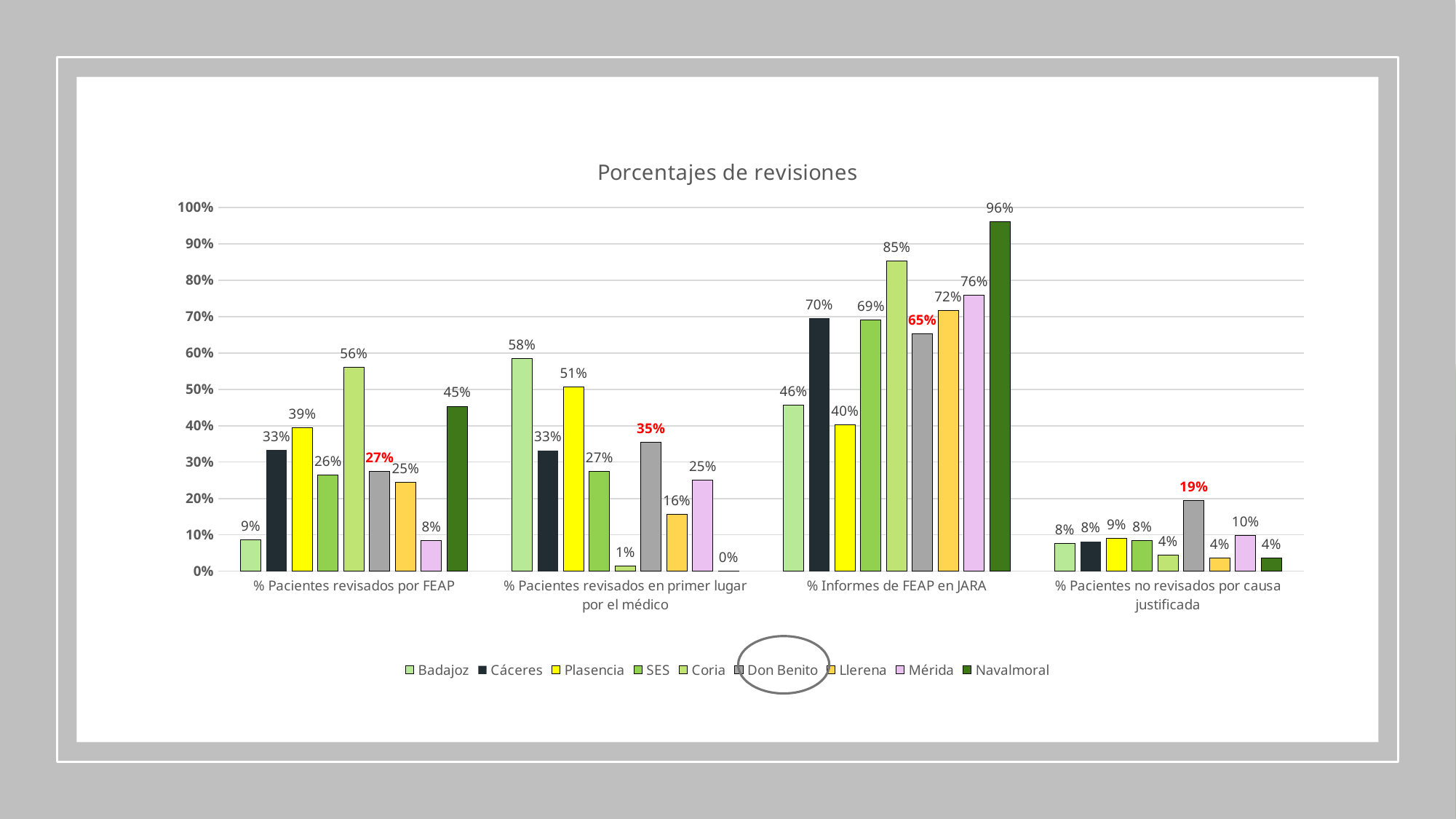
Which series has the lowest value in the "% Pacientes revisados por FEAP" category? Mérida How many categories are shown on the x axis? 4 In the "% Pacientes no revisados por causa justificada" category, which is larger: Don Benito or Mérida? Don Benito What kind of chart is shown on the slide? Bar chart What is the title of the chart? Porcentajes de revisiones Which series has the highest value in the "% Informes de FEAP en JARA" category? Navalmoral Which legend entry is circled on the slide? Don Benito What is the value for Don Benito in the "% Informes de FEAP en JARA" category? 65% How many series does the legend list? 9 What is the value for Navalmoral in the "% Pacientes revisados en primer lugar por el médico" category? 0% What is the value for Coria in the "% Pacientes revisados por FEAP" category? 56% What is the difference between Badajoz and Cáceres in the "% Pacientes revisados en primer lugar por el médico" category? 25%